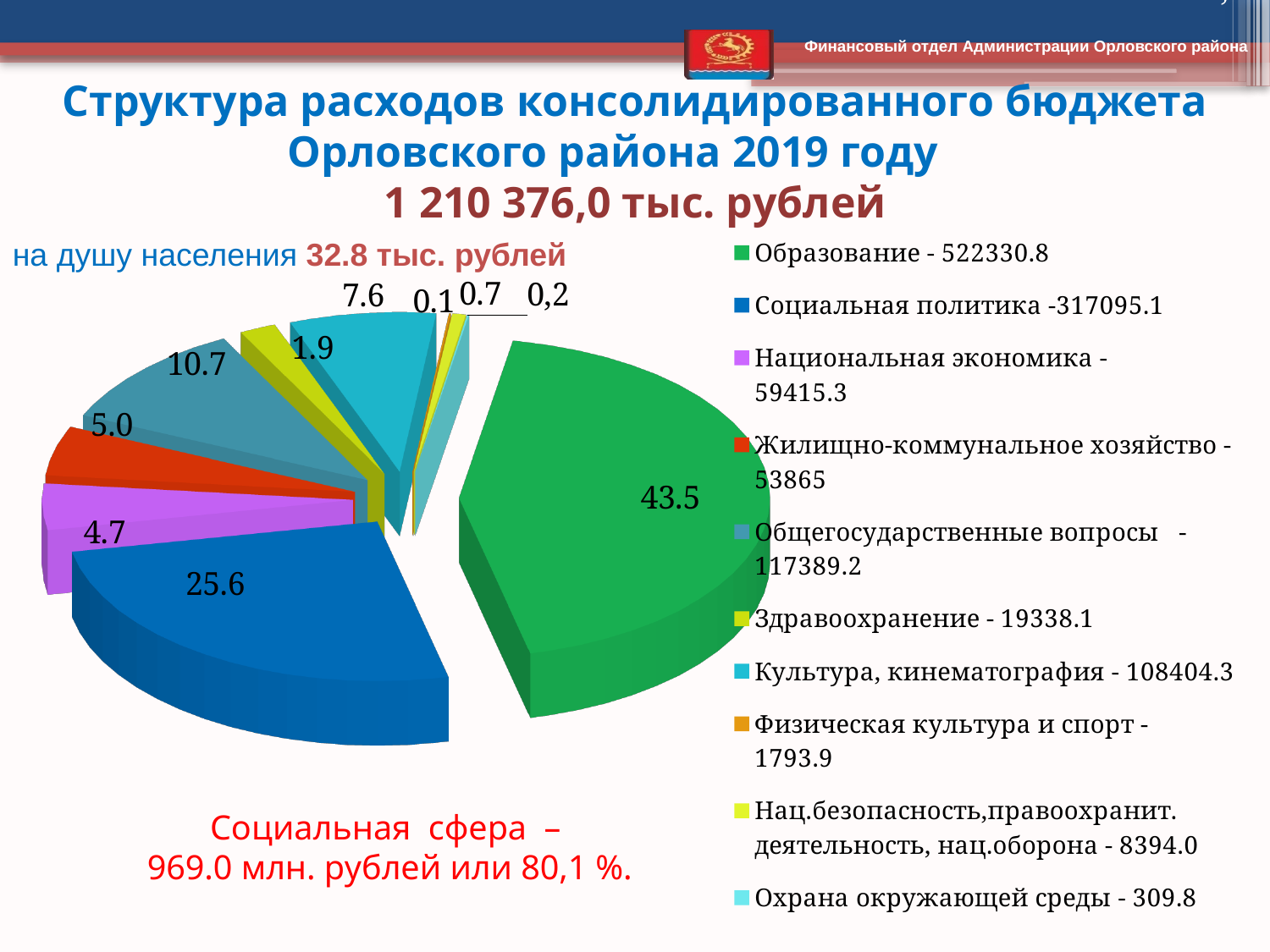
Which is larger according to the legend: Социальная политика or Национальная экономика? Социальная политика What value is given for Образование in the legend? 522330.8 What data label is shown on the green Образование slice of the pie chart? 43.5 What is the difference between the data labels of the Образование slice (43.5) and the Социальная политика slice (25.6)? 17.9 What type of chart is shown on the slide? pie chart What value is given for Здравоохранение in the legend? 19338.1 What per-capita amount (на душу населения) is stated on the slide? 32.8 тыс. рублей What total amount of consolidated budget expenditure is stated in the slide title? 1 210 376,0 тыс. рублей How many categories does the legend of the pie chart list? 10 Which category has the smallest value listed in the legend? Охрана окружающей среды Which category has the largest slice in the pie chart? Образование What value is given for Культура, кинематография in the legend? 108404.3